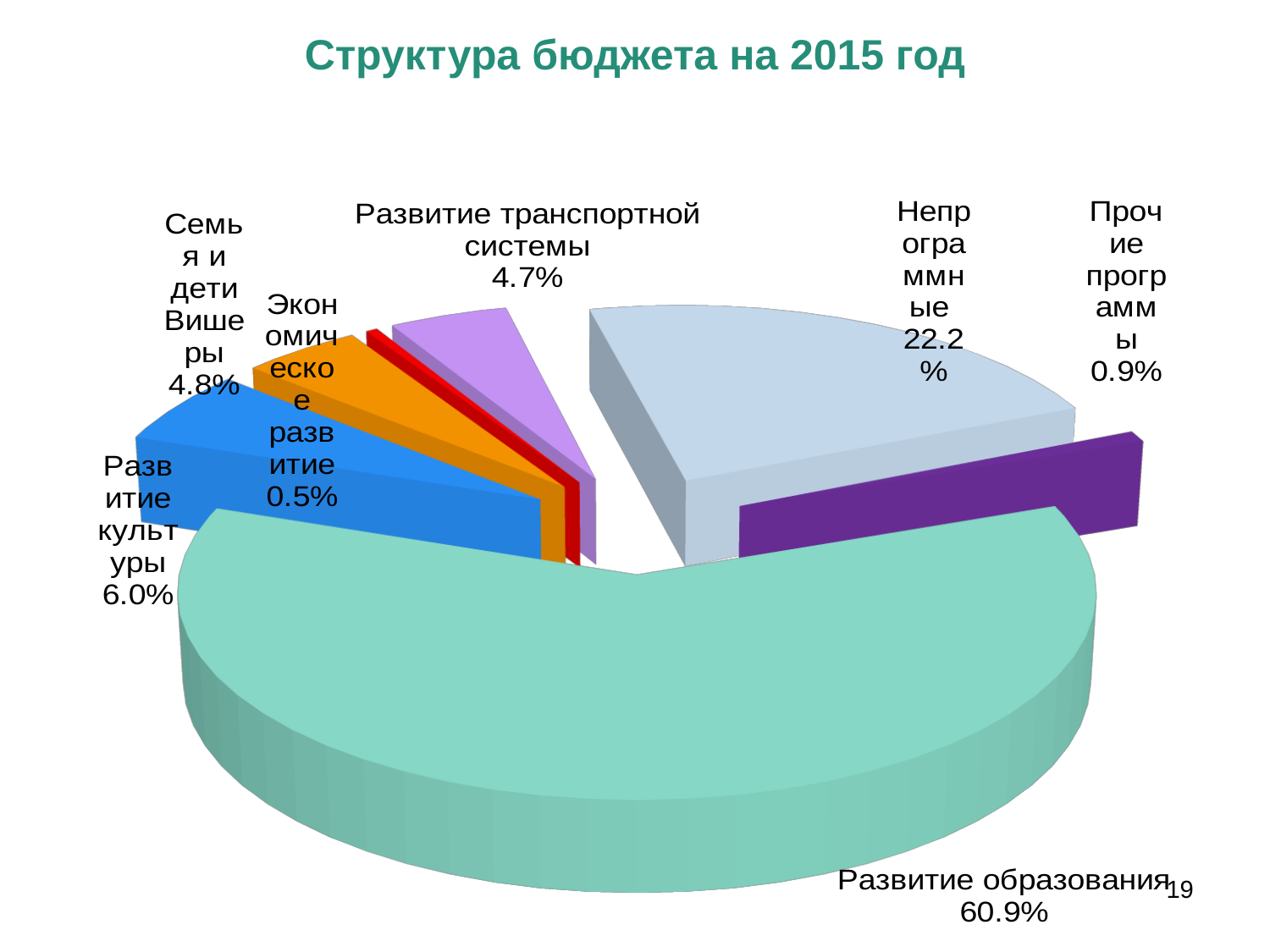
How many slices does the pie chart have? 7 Which category has the largest share of the budget? Развитие образования What share of the budget goes to Развитие образования? 60.9% What is the value for Развитие транспортной системы? 4.7% What is the difference between the shares for Развитие образования and Непрограммные? 38.7% Which category has the smallest share of the budget? Экономическое развитие What is the value for Развитие культуры? 6.0% What is the value for Экономическое развитие? 0.5% Which is larger, the share for Семья и дети Вишеры or the share for Развитие транспортной системы? Семья и дети Вишеры What is the title of the chart? Структура бюджета на 2015 год What share of the budget is labelled Непрограммные? 22.2% What kind of chart is shown on the slide? pie chart